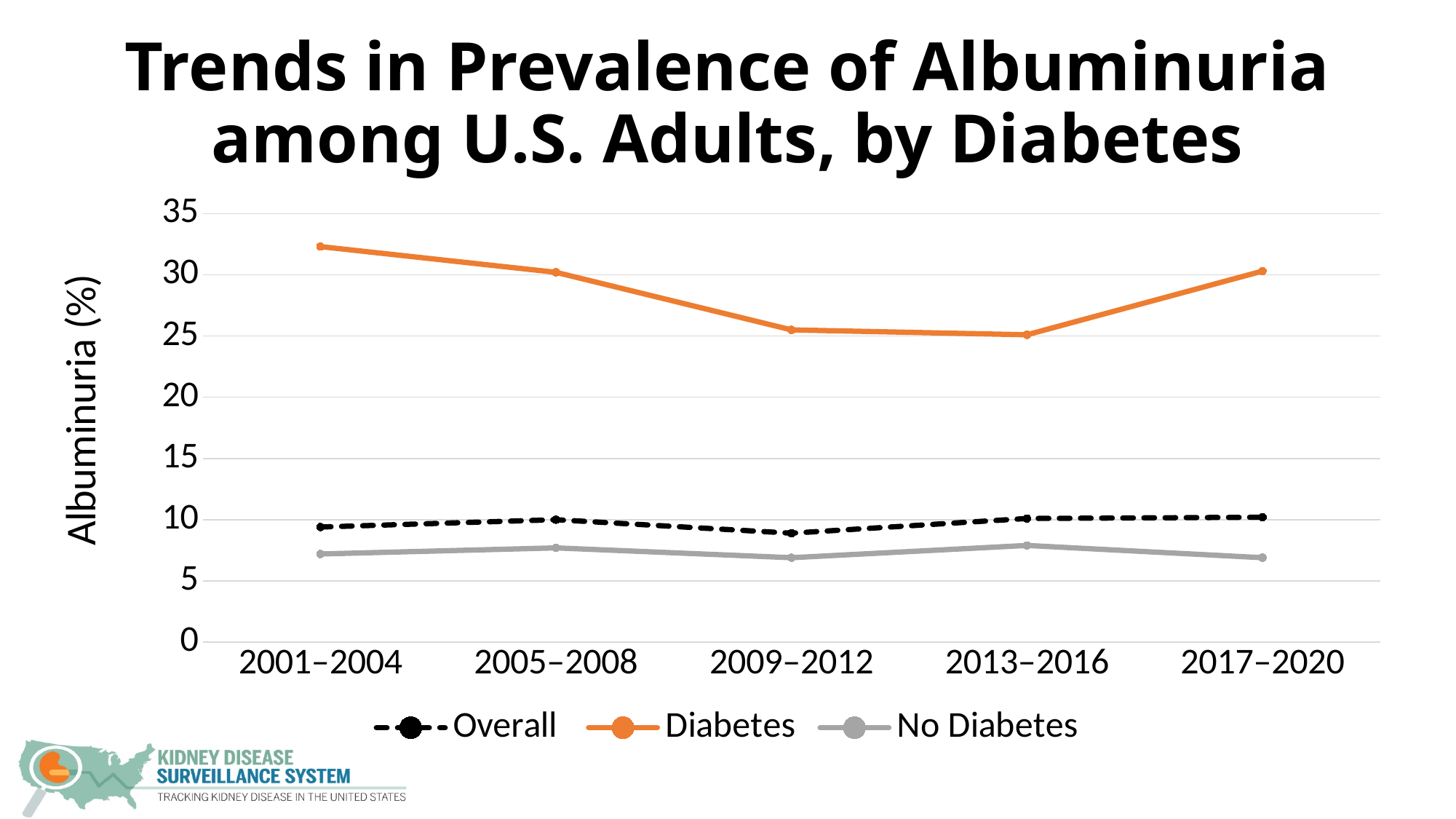
Which series has the highest values across all periods? Diabetes Does the Diabetes series rise or fall from 2001–2004 to 2013–2016? fall What kind of chart is shown on the slide? Line chart Is the value for Diabetes in 2001–2004 greater or less than 30? greater In 2017–2020, which is larger: the value for Diabetes or the value for No Diabetes? Diabetes In which period is the Diabetes series at its highest? 2001–2004 How many time periods are shown on the x axis? 5 What is the label on the y axis? Albuminuria (%) Is the value for No Diabetes in 2013–2016 greater or less than 10? less How many series does the legend list? 3 Is the value for Overall in 2009–2012 greater or less than 10? less In which period is the Overall series at its lowest? 2009–2012